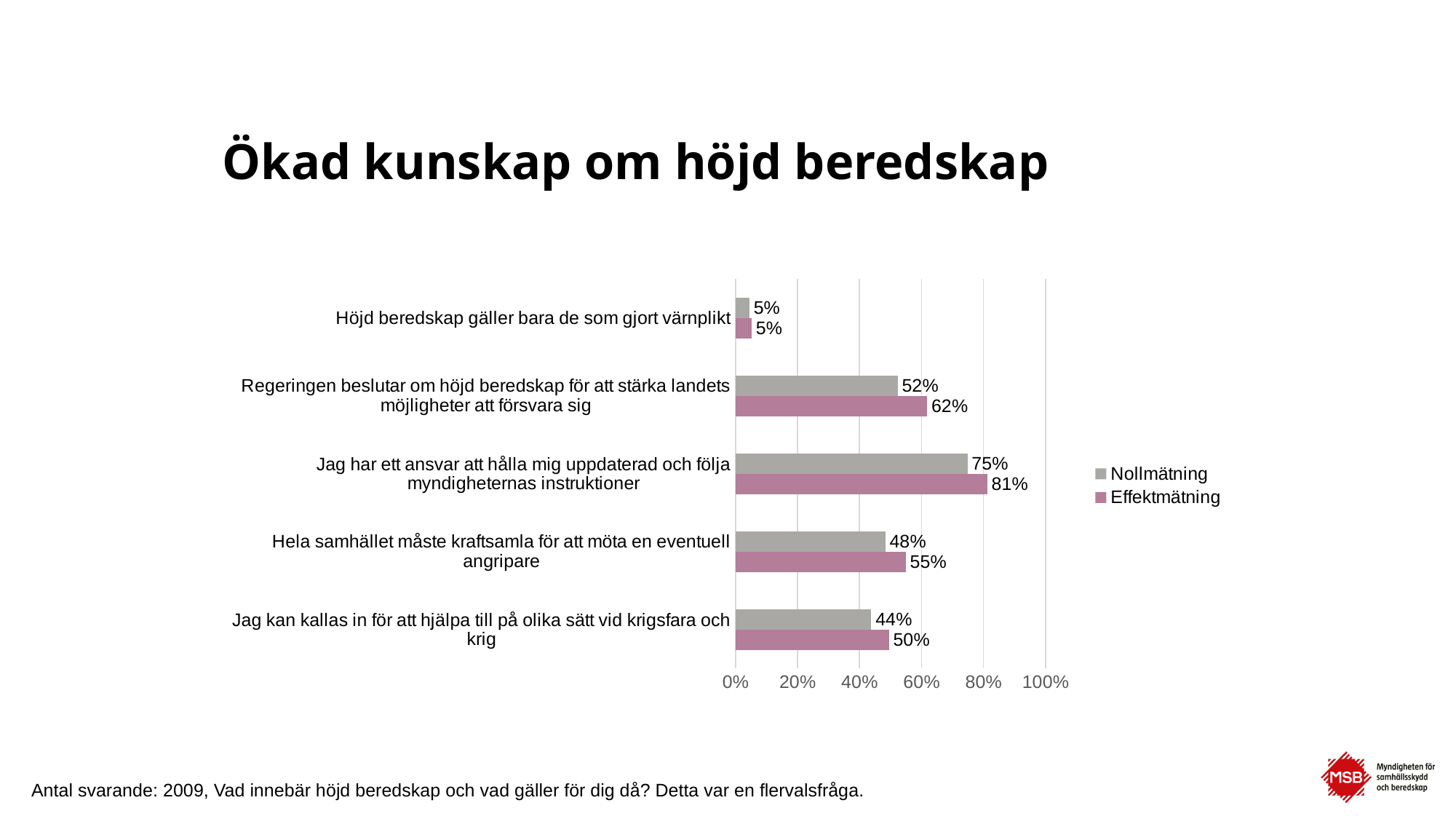
What is the Effektmätning value for "Jag har ett ansvar att hålla mig uppdaterad och följa myndigheternas instruktioner"? 81% What is the Effektmätning value for "Jag kan kallas in för att hjälpa till på olika sätt vid krigsfara och krig"? 50% What is the Nollmätning value for "Regeringen beslutar om höjd beredskap för att stärka landets möjligheter att försvara sig"? 52% Which category has the lowest Nollmätning value? Höjd beredskap gäller bara de som gjort värnplikt What kind of chart is shown on the slide? Bar chart What are the two series named in the legend? Nollmätning and Effektmätning Which category has the highest Effektmätning value? Jag har ett ansvar att hålla mig uppdaterad och följa myndigheternas instruktioner What is the difference between the Effektmätning and Nollmätning values for "Regeringen beslutar om höjd beredskap för att stärka landets möjligheter att försvara sig"? 10% Which is larger for "Hela samhället måste kraftsamla för att möta en eventuell angripare": the Nollmätning value or the Effektmätning value? Effektmätning Is the Effektmätning value for "Jag har ett ansvar att hålla mig uppdaterad och följa myndigheternas instruktioner" greater or less than 80%? greater How many categories are shown on the chart? 5 How many series does the legend list? 2